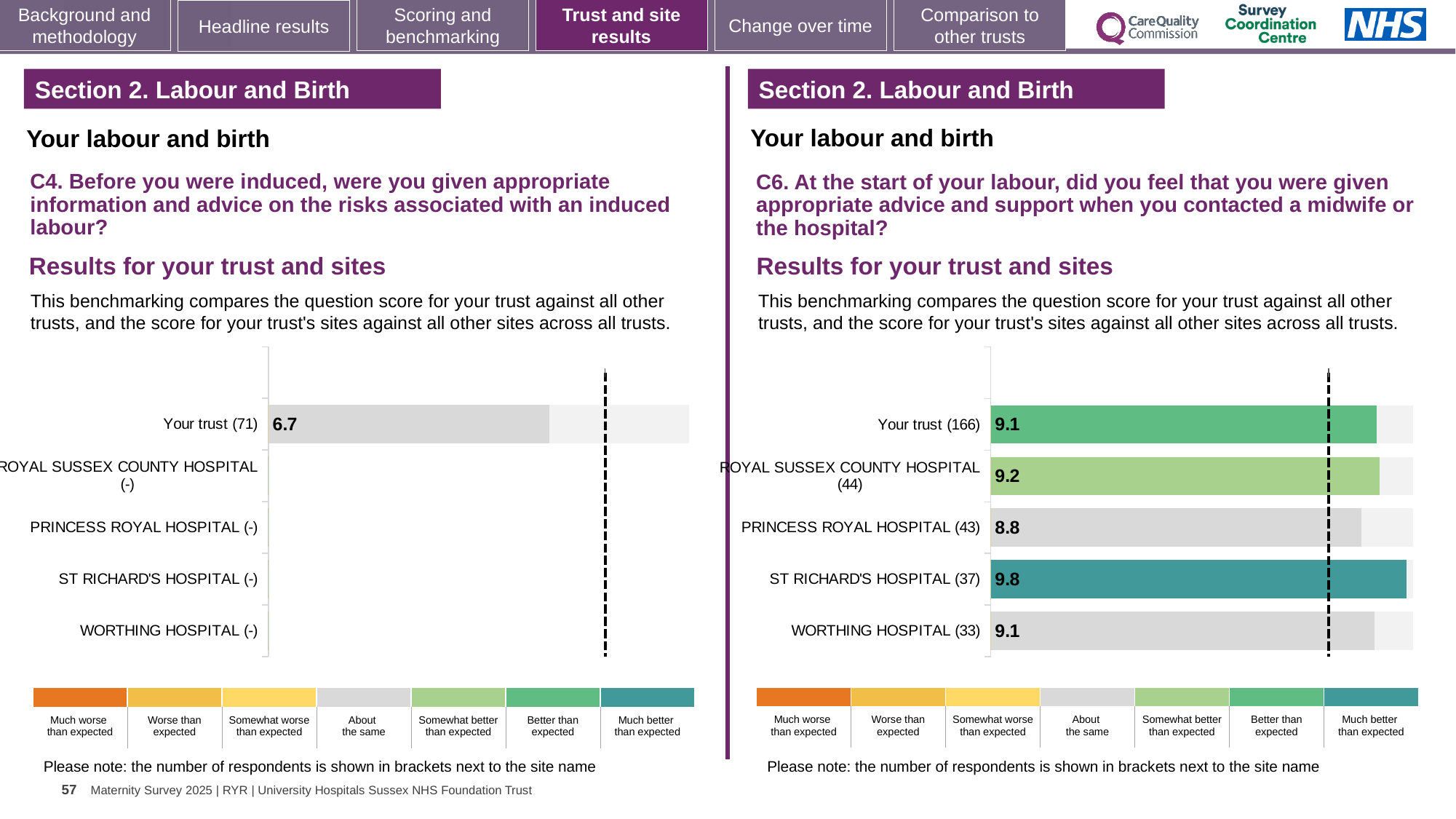
On the right-hand chart (C6), which site has the lowest score? PRINCESS ROYAL HOSPITAL (43) On the right-hand chart (C6), what is the score for PRINCESS ROYAL HOSPITAL (43)? 8.8 What type of chart is used on the right-hand side (C6)? Bar chart On the right-hand chart (C6), which site has the highest score? ST RICHARD'S HOSPITAL (37) On the left-hand chart (C4), what is the score for Your trust (71)? 6.7 How many bars with a printed score are shown on the right-hand chart (C6)? 5 On the right-hand chart (C6), what is the score for ST RICHARD'S HOSPITAL (37)? 9.8 On the right-hand chart (C6), which has the larger score: ROYAL SUSSEX COUNTY HOSPITAL (44) or WORTHING HOSPITAL (33)? ROYAL SUSSEX COUNTY HOSPITAL (44) On the right-hand chart (C6), what is the score for Your trust (166)? 9.1 How many bars with a printed score are shown on the left-hand chart (C4)? 1 On the right-hand chart (C6), what benchmark category does the colour of the ST RICHARD'S HOSPITAL (37) bar correspond to in the legend? Much better than expected On the right-hand chart (C6), what is the difference between the scores for ST RICHARD'S HOSPITAL (37) and PRINCESS ROYAL HOSPITAL (43)? 1.0